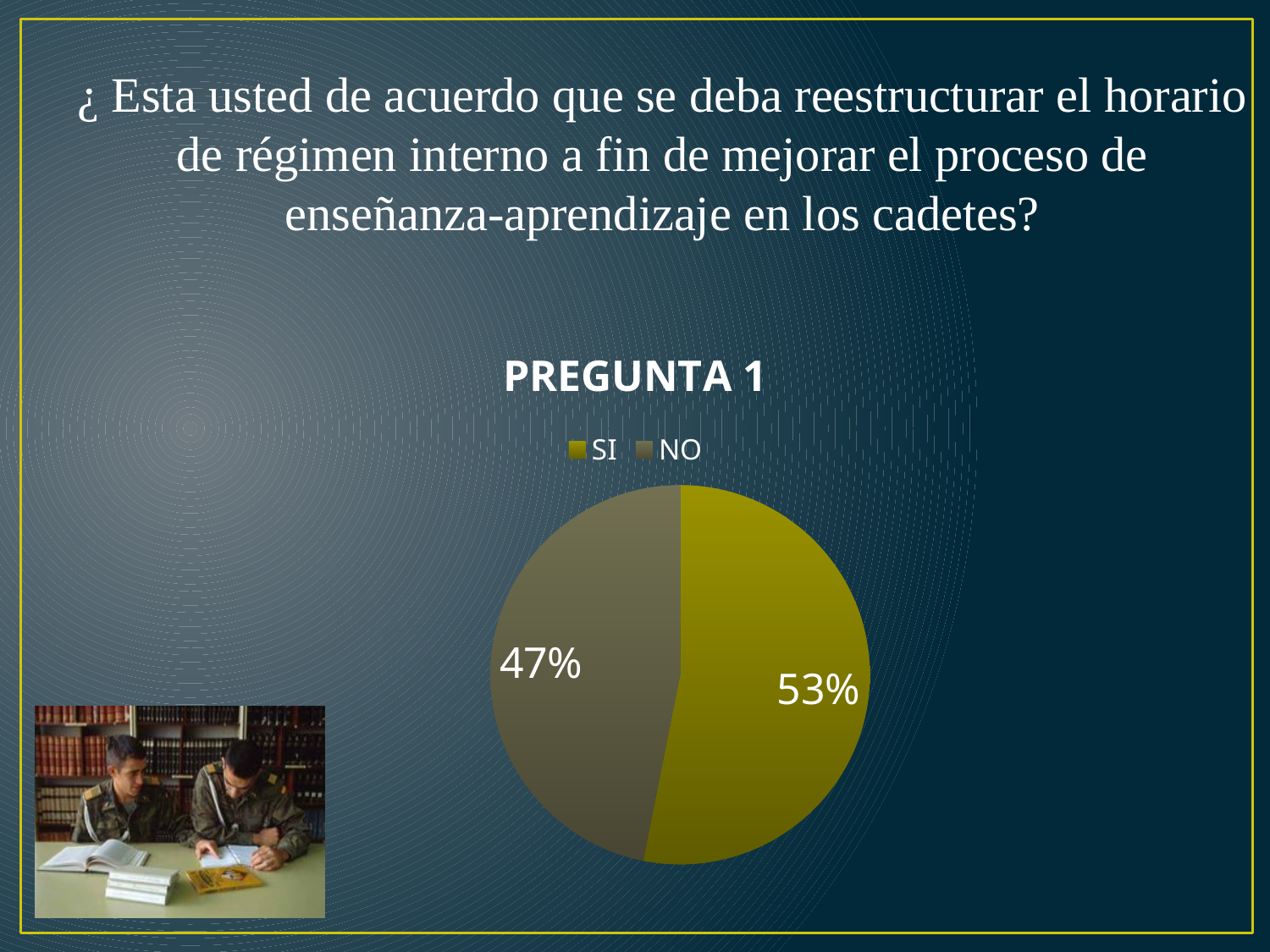
What percentage of the pie is labelled for NO? 47% What is the chart's title? PREGUNTA 1 What kind of chart is shown on the slide? pie chart What percentage of the pie is labelled for SI? 53% Which legend entry is shown in the yellow-olive colour? SI What share of the pie does the SI slice represent? 53% Which slice is the smallest? NO Which is larger, the SI slice or the NO slice? SI How many entries does the legend list? 2 How many slices does the pie chart have? 2 Which slice is the largest? SI What is the difference in percentage points between the SI and NO slices? 6